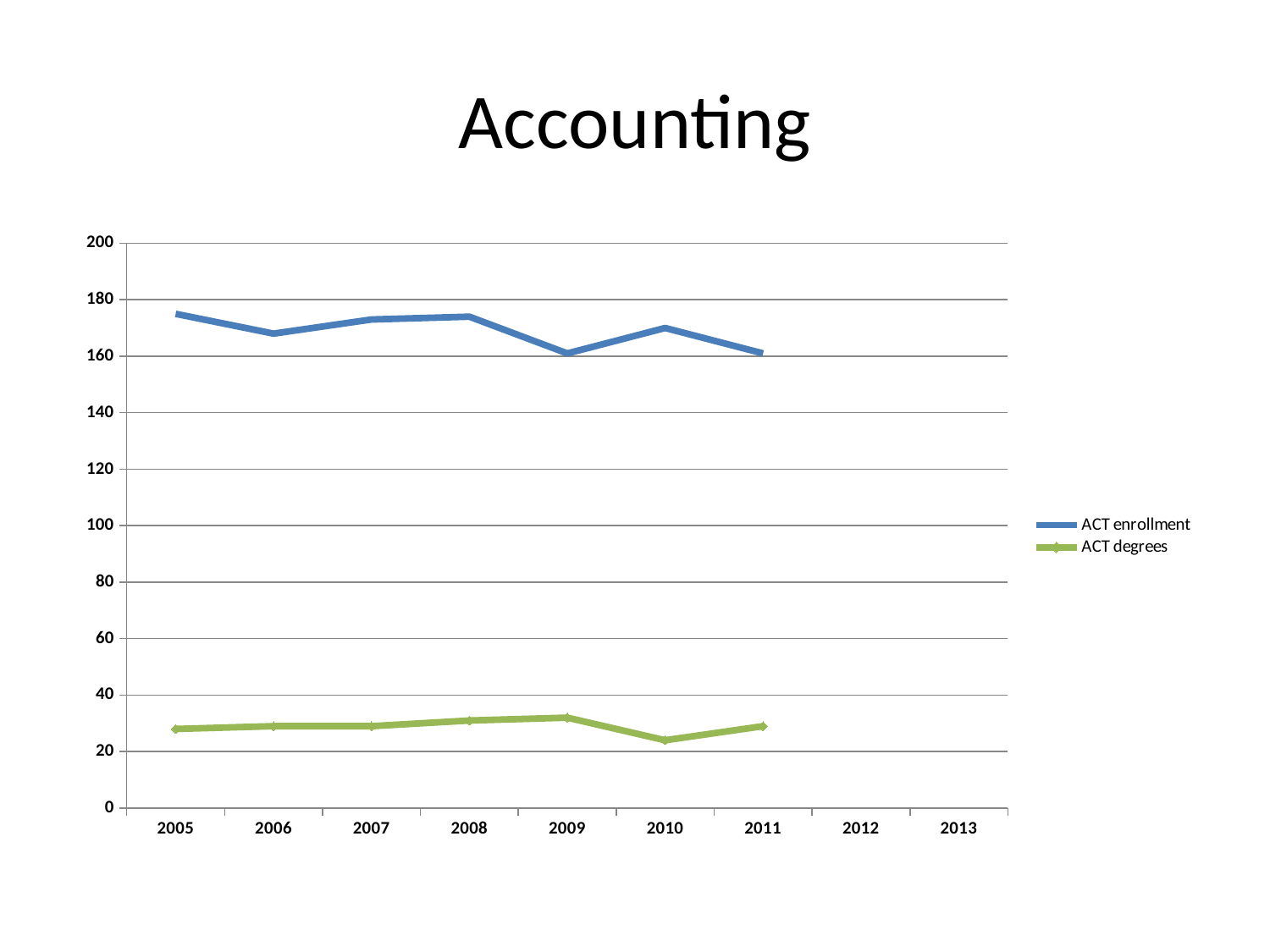
Does ACT enrollment rise or fall from 2008 to 2009? fall Which is larger in 2011, ACT enrollment or ACT degrees? ACT enrollment Is the value for ACT enrollment in 2005 greater or less than 160? greater How many years are labelled on the x axis? 9 What is the title of the chart? Accounting Is the value for ACT enrollment in 2009 greater or less than 180? less In which year is the ACT degrees value lowest? 2010 What kind of chart is shown on the slide? line chart Which series is drawn in green? ACT degrees Is the value for ACT degrees in 2009 greater or less than 20? greater How many series does the legend list? 2